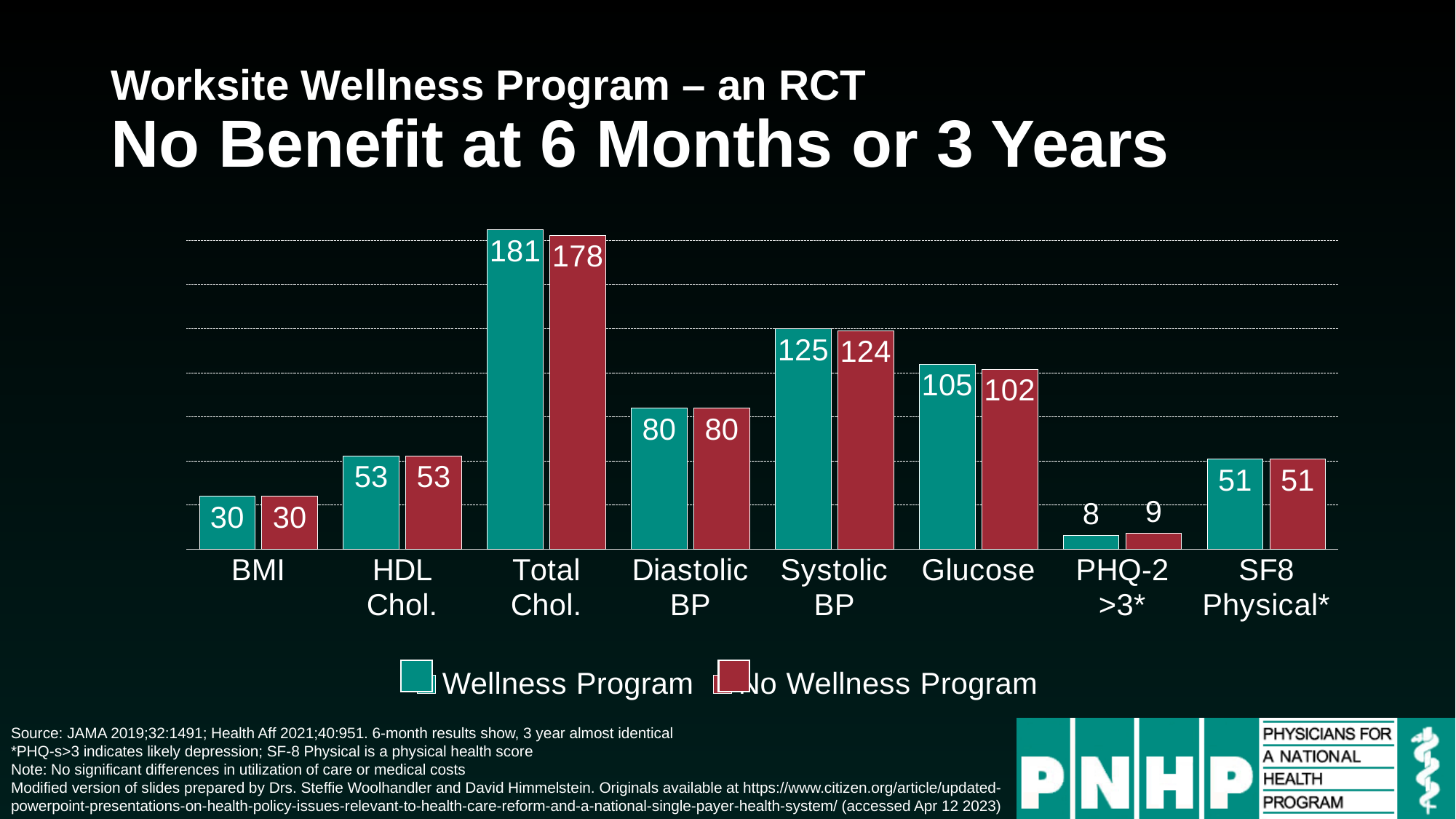
What is the No Wellness Program value for Glucose? 102 What is the difference between the Wellness Program and No Wellness Program values for Glucose? 3 Which category has the lowest No Wellness Program value? PHQ-2 >3* What is the Wellness Program value for Total Chol.? 181 What is the No Wellness Program value for PHQ-2 >3*? 9 What colour are the Wellness Program bars? Teal How many series does the legend list? 2 Which category has the highest Wellness Program value? Total Chol. What is the difference between the Wellness Program and No Wellness Program values for Total Chol.? 3 Which is larger for Systolic BP: the Wellness Program value or the No Wellness Program value? Wellness Program What kind of chart is shown on the slide? Bar chart How many categories are shown on the x axis? 8